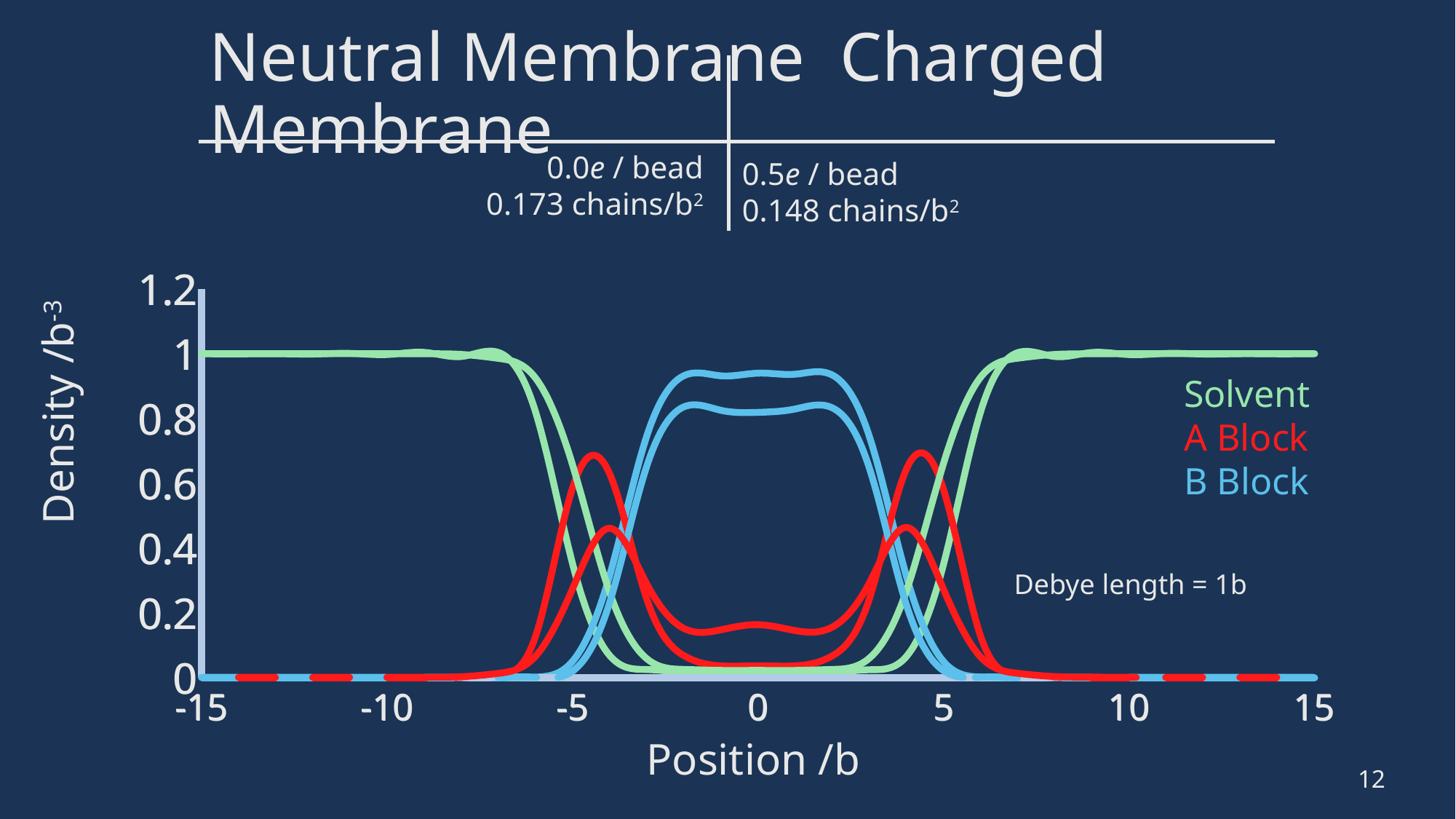
Is the A Block density at position 0 greater or less than 0.4? less Does the B Block density rise or fall as position goes from -5 to 0? rise Which series has the highest density at position -15? Solvent What kind of chart is shown on the slide? line chart Is the Solvent density at position -15 greater or less than 0.8? greater What is the label of the x axis? Position /b How many series does the legend list? 3 Is the B Block density at position 0 greater or less than 0.6? greater Does the Solvent density rise or fall as position goes from -10 to -5? fall Which series has the highest density at position 0? B Block Which colour represents the A Block series? red